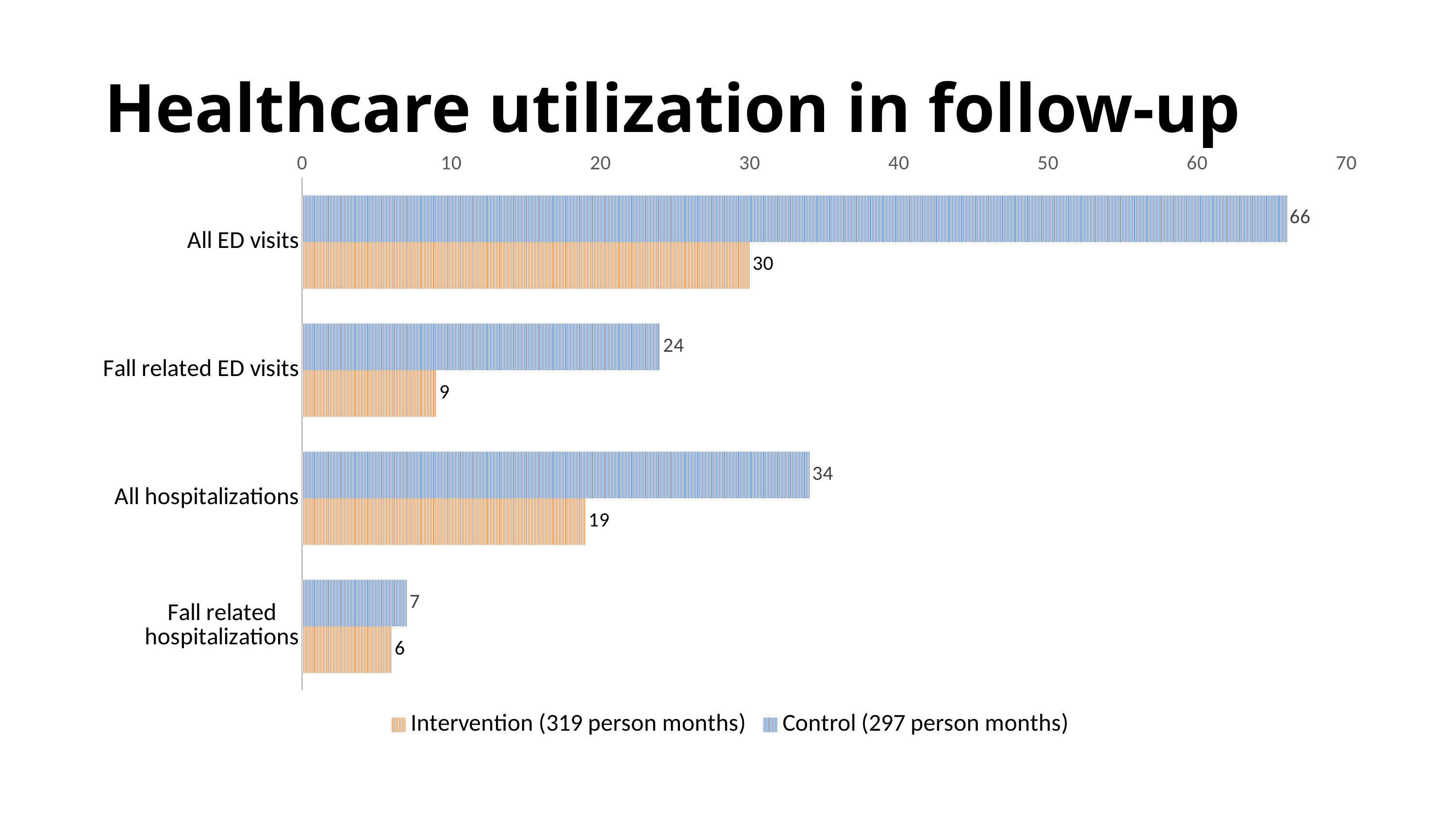
How many series does the legend list? 2 What is the difference between the Control and Intervention values for All hospitalizations? 15 Which is larger for Fall related hospitalizations, the Control value or the Intervention value? Control Which category has the lowest Intervention value? Fall related hospitalizations What is the difference between the Control and Intervention values for All ED visits? 36 What is the Control value for All ED visits? 66 How many categories are shown on the chart? 4 What is the Intervention value for All hospitalizations? 19 What is the title of the chart? Healthcare utilization in follow-up Which category has the highest Control value? All ED visits What is the Intervention value for Fall related ED visits? 9 What kind of chart is shown on the slide? Bar chart